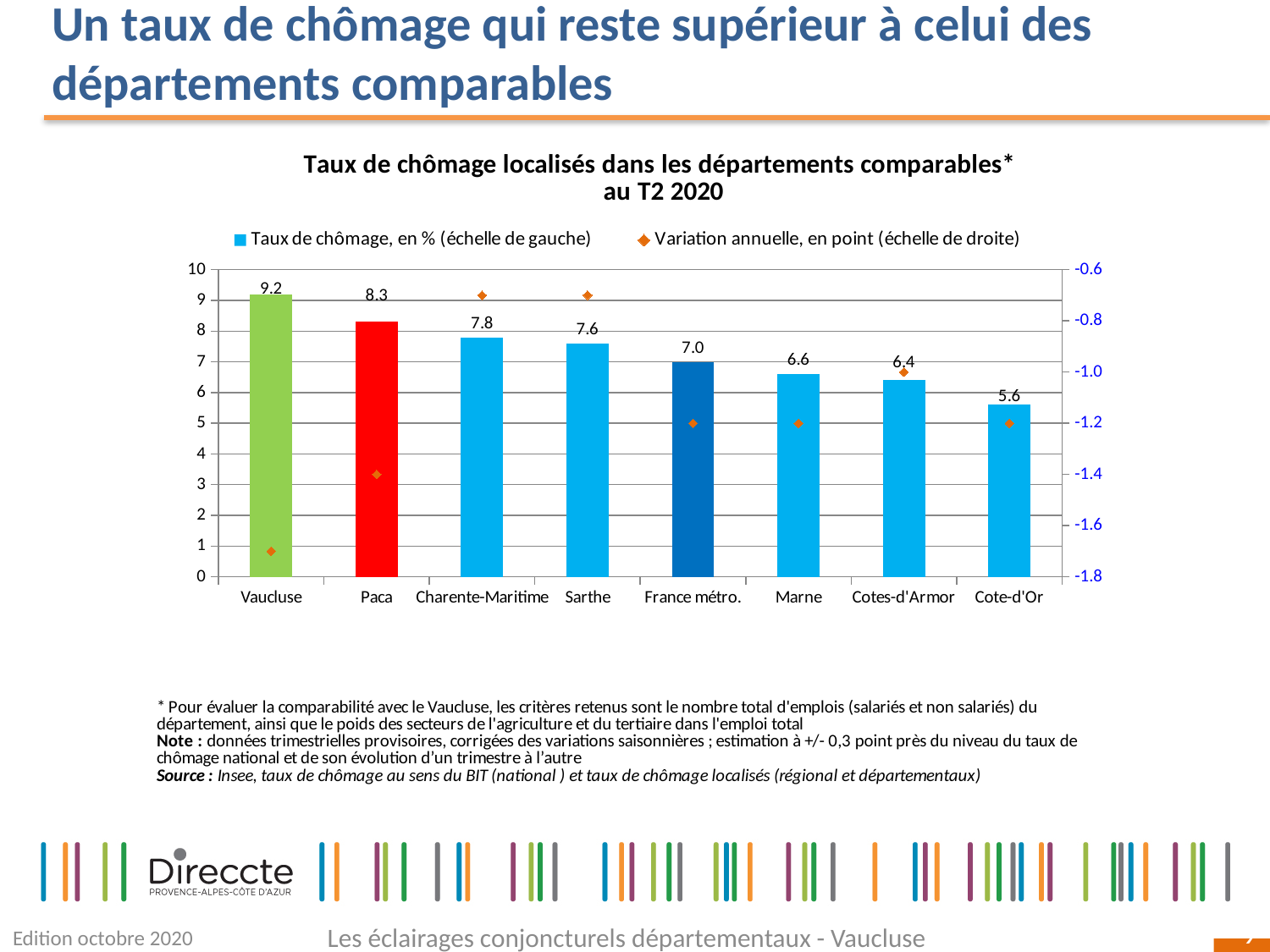
What is the unemployment rate (Taux de chômage) for Vaucluse? 9.2 Which has a higher unemployment rate, Marne or Cotes-d'Armor? Marne Is the annual variation (Variation annuelle) for Vaucluse greater or less than -1.6? less What is the difference between the unemployment rates of Vaucluse and Cote-d'Or? 3.6 What is the unemployment rate (Taux de chômage) for France métro.? 7.0 What is the unemployment rate (Taux de chômage) for Sarthe? 7.6 How many categories are shown on the x axis? 8 Which category has the highest unemployment rate? Vaucluse Is the annual variation (Variation annuelle) for Charente-Maritime greater or less than -0.8? greater What is the difference between the unemployment rates of Vaucluse and Paca? 0.9 Which category has the lowest unemployment rate? Cote-d'Or How many series does the legend list? 2